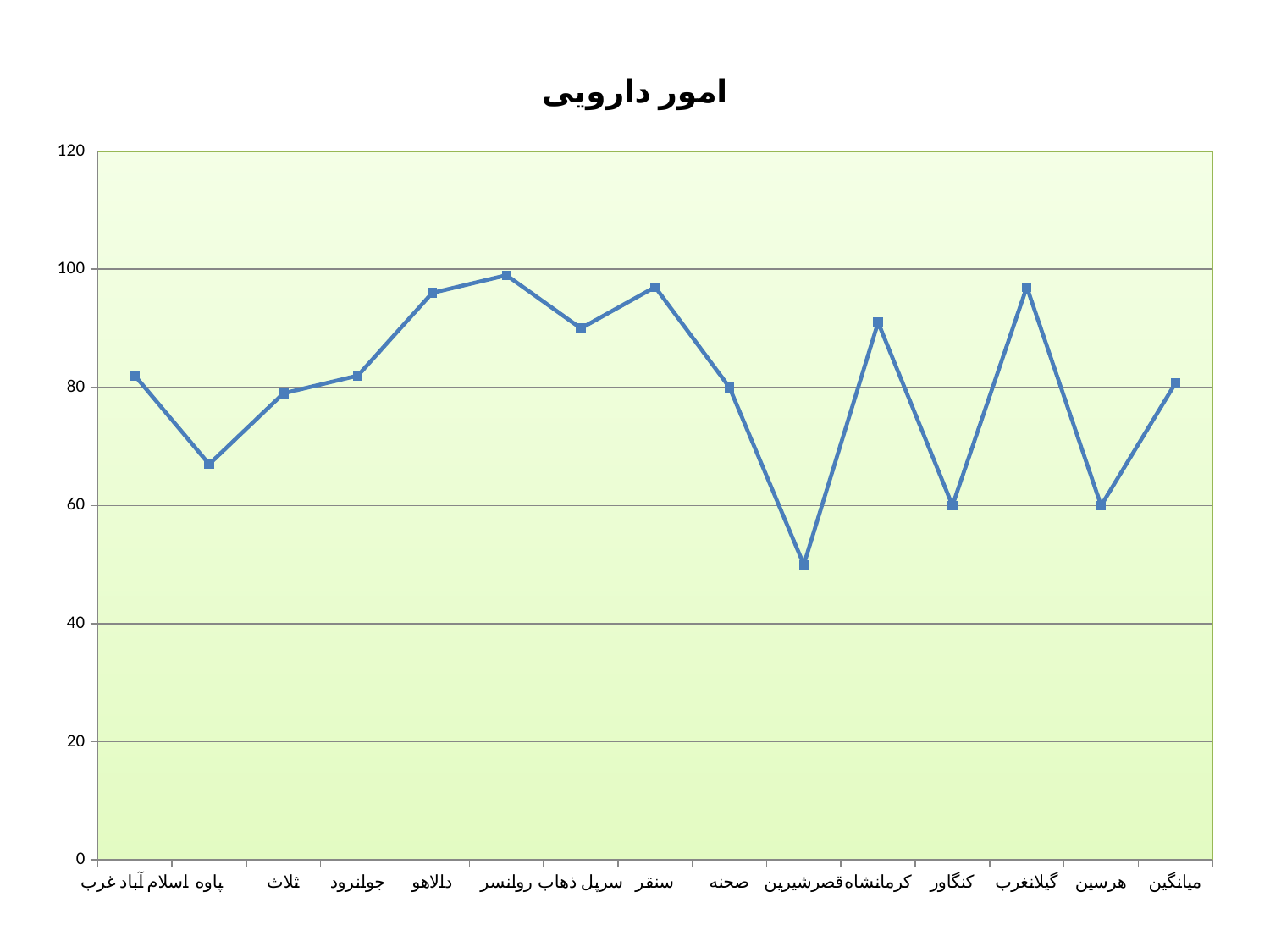
How many categories are plotted along the x axis? 15 What kind of chart is shown on the slide? line chart What is the title of the chart? امور دارویی Which category has the lowest value? قصرشیرین Is the value for دالاهو greater or less than 80? greater What is the value for هرسین? 60 Is the value for پاوه greater or less than 80? less Which is larger, the value for پاوه or the value for ثلاث? ثلاث What is the value for صحنه? 80 What is the value for کنگاور? 60 Is the value for قصرشیرین greater or less than 60? less Which is larger, the value for کرمانشاه or the value for کنگاور? کرمانشاه